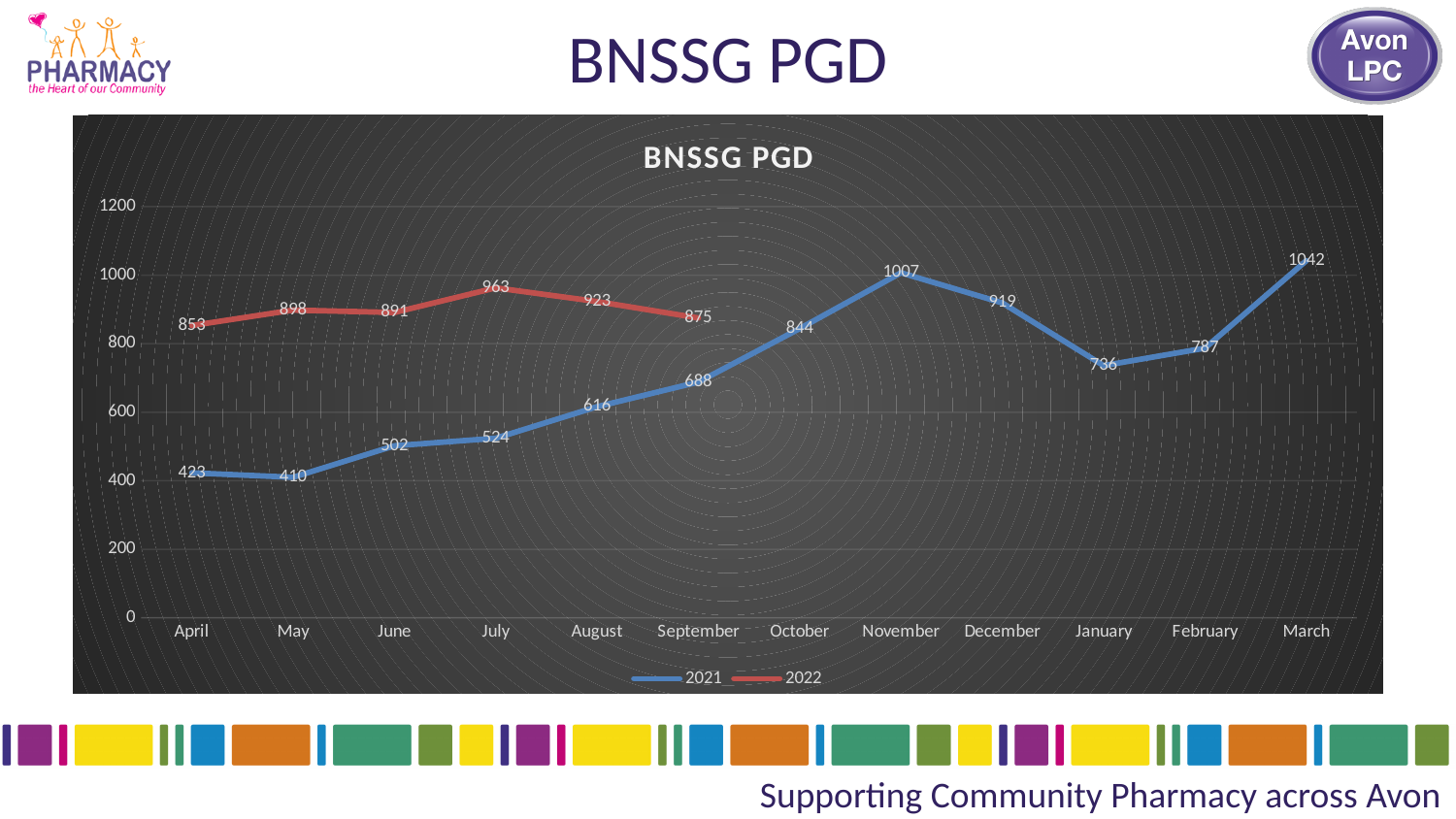
Does the 2021 series rise or fall from April to November? Rise Which is larger in September, the 2021 value or the 2022 value? 2022 What is the value for 2021 in November? 1007 What is the value for 2021 in April? 423 What kind of chart is shown? Line chart Which month has the highest value for the 2021 series? March How many months are shown on the x axis? 12 What is the difference between the 2022 and 2021 values in April? 430 Which month has the lowest value for the 2021 series? May How many series does the legend list? 2 Which month has the lowest value for the 2022 series? April What is the value for 2022 in July? 963